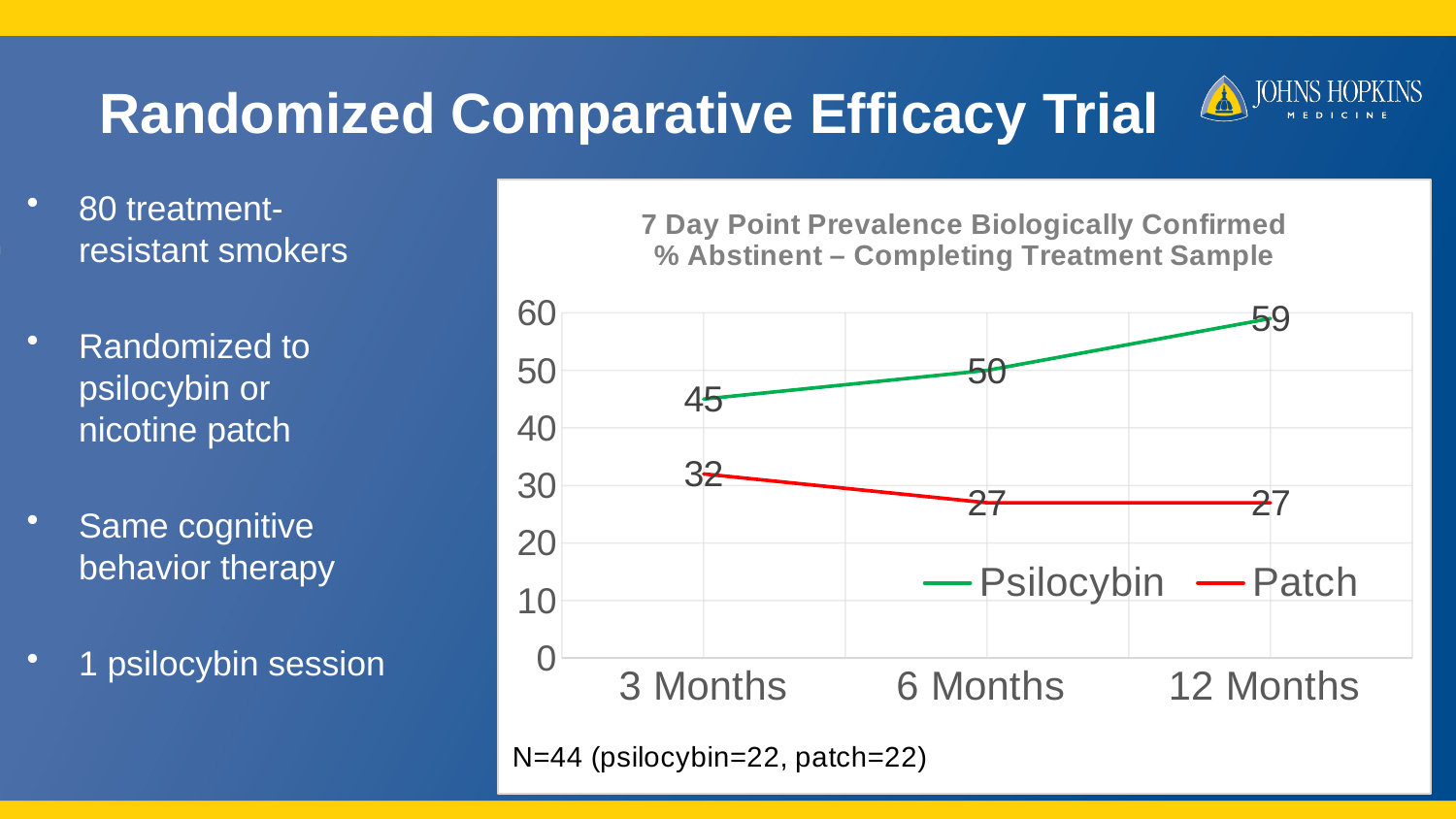
At which time point is the Psilocybin value highest? 12 Months Does the Psilocybin series rise or fall from 3 Months to 12 Months? Rise How many time points are shown on the x axis? 3 At which time point is the Patch value highest? 3 Months What is the Psilocybin value at 6 Months? 50 What is the difference between the Psilocybin values at 3 Months and 12 Months? 14 What kind of chart is shown on the slide? Line chart How many series does the legend list? 2 What is the Psilocybin value at 12 Months? 59 What is the difference between the Psilocybin and Patch values at 12 Months? 32 Which series has the larger value at 6 Months, Psilocybin or Patch? Psilocybin What is the Patch value at 3 Months? 32